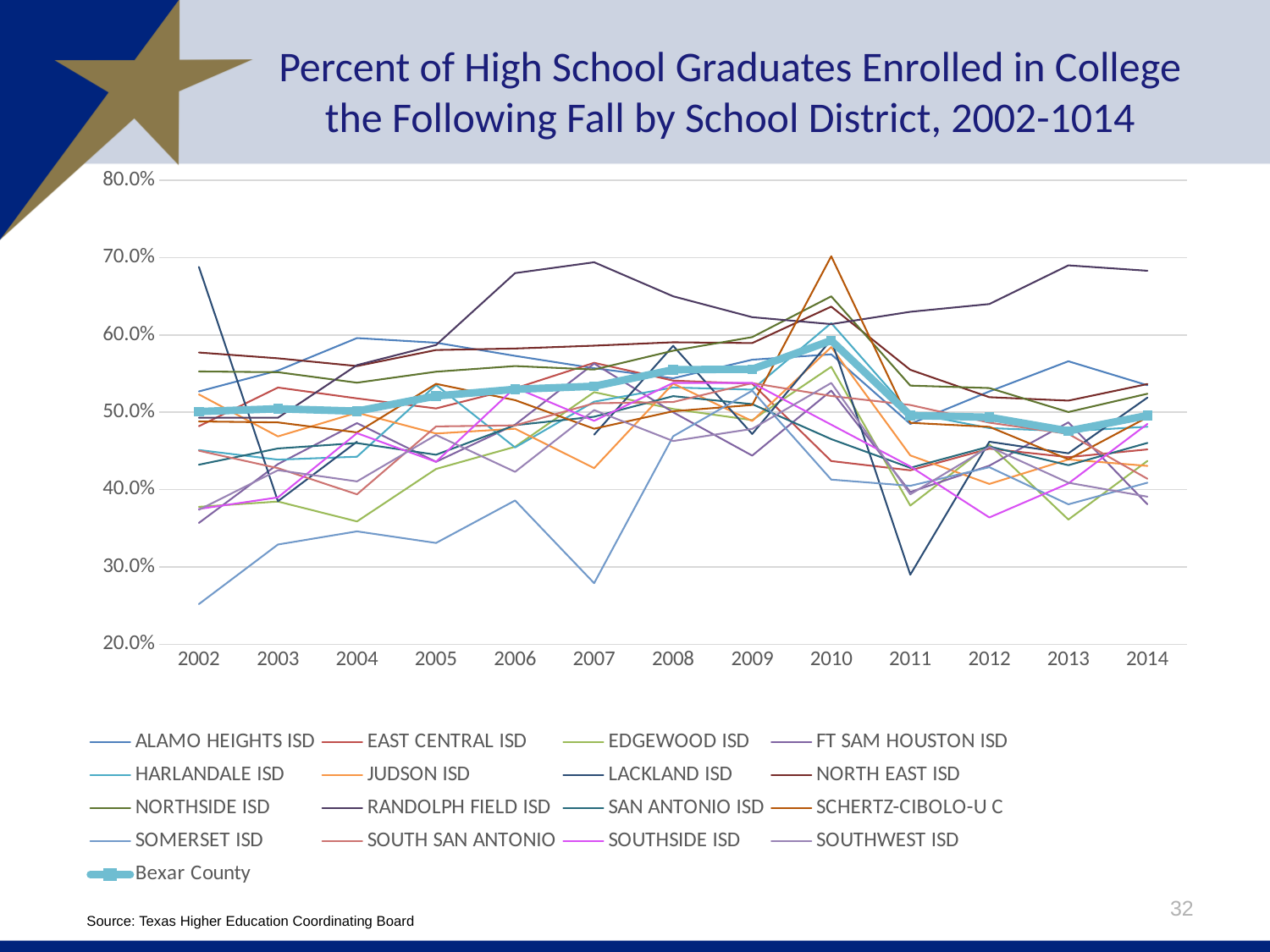
Is the lowest value plotted in 2002 greater or less than 30%? less Is the highest value plotted in 2010 greater or less than 60%? greater Is the value for Bexar County in 2011 greater or less than 60%? less What source is cited for the chart? Texas Higher Education Coordinating Board Does the Bexar County line rise or fall from 2002 to 2010? rise How many series does the legend list? 17 In which year does the Bexar County line reach its highest value? 2010 What is the title of the chart? Percent of High School Graduates Enrolled in College the Following Fall by School District, 2002-1014 How many years are shown along the x axis? 13 What kind of chart is shown on the slide? line chart